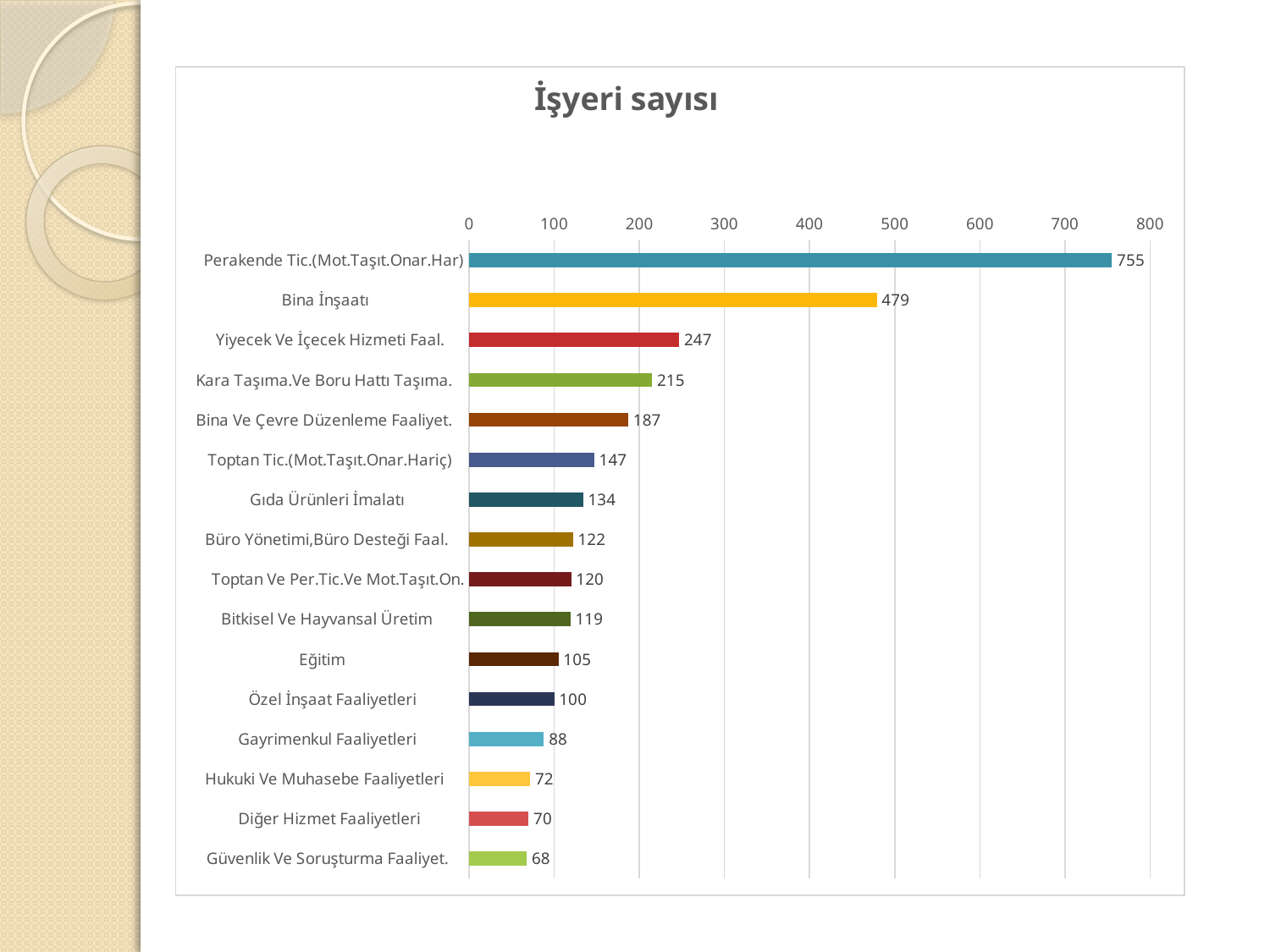
What is the value for Eğitim? 105 Is the value for Bina Ve Çevre Düzenleme Faaliyet. greater or less than 100? greater Which is larger, the value for Toptan Tic.(Mot.Taşıt.Onar.Hariç) or the value for Gayrimenkul Faaliyetleri? Toptan Tic.(Mot.Taşıt.Onar.Hariç) What kind of chart is shown on the slide? bar chart Which category has the lowest value? Güvenlik Ve Soruşturma Faaliyet. Which category has the highest value? Perakende Tic.(Mot.Taşıt.Onar.Har) What is the value for Bina İnşaatı? 479 What is the difference between the values for Perakende Tic.(Mot.Taşıt.Onar.Har) and Bina İnşaatı? 276 What is the difference between the values for Yiyecek Ve İçecek Hizmeti Faal. and Kara Taşıma.Ve Boru Hattı Taşıma.? 32 How many categories are shown in the chart? 16 What is the value for Gıda Ürünleri İmalatı? 134 What is the title of the chart? İşyeri sayısı